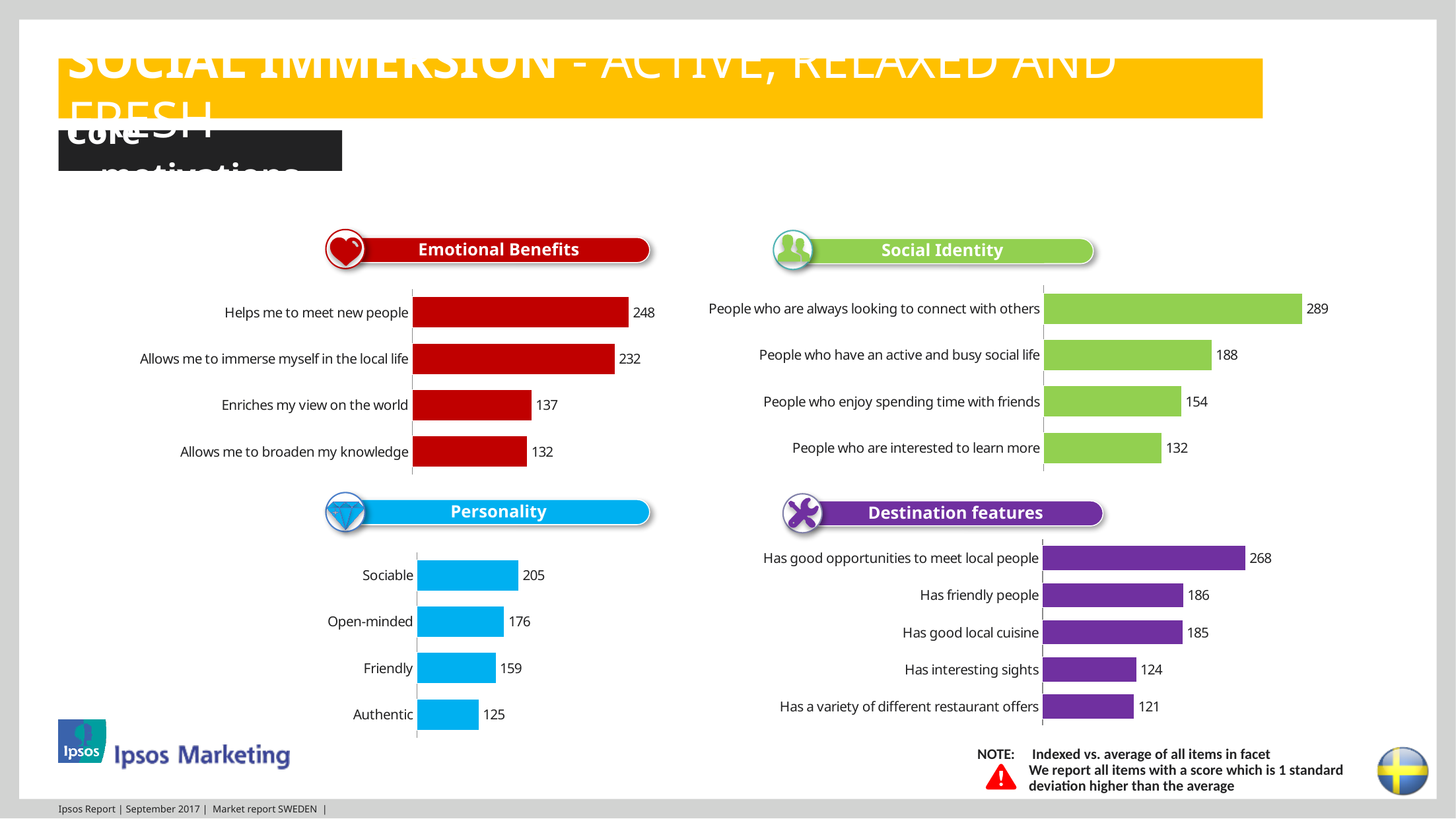
In the Destination features chart, what is the difference between "Has good opportunities to meet local people" and "Has a variety of different restaurant offers"? 147 How many categories are shown in the Destination features chart? 5 In the Emotional Benefits chart, what is the difference between "Helps me to meet new people" and "Allows me to immerse myself in the local life"? 16 In the Social Identity chart, which category has the highest value? People who are always looking to connect with others In the Personality chart, which is larger, "Friendly" or "Authentic"? Friendly In the Emotional Benefits chart, what is the value for "Helps me to meet new people"? 248 In the Personality chart, what is the value for "Open-minded"? 176 In the Emotional Benefits chart, which category has the lowest value? Allows me to broaden my knowledge In the Destination features chart, what is the value for "Has good local cuisine"? 185 What type of chart is the Personality chart? Bar chart In the Social Identity chart, what is the value for "People who have an active and busy social life"? 188 How many categories are shown in the Social Identity chart? 4